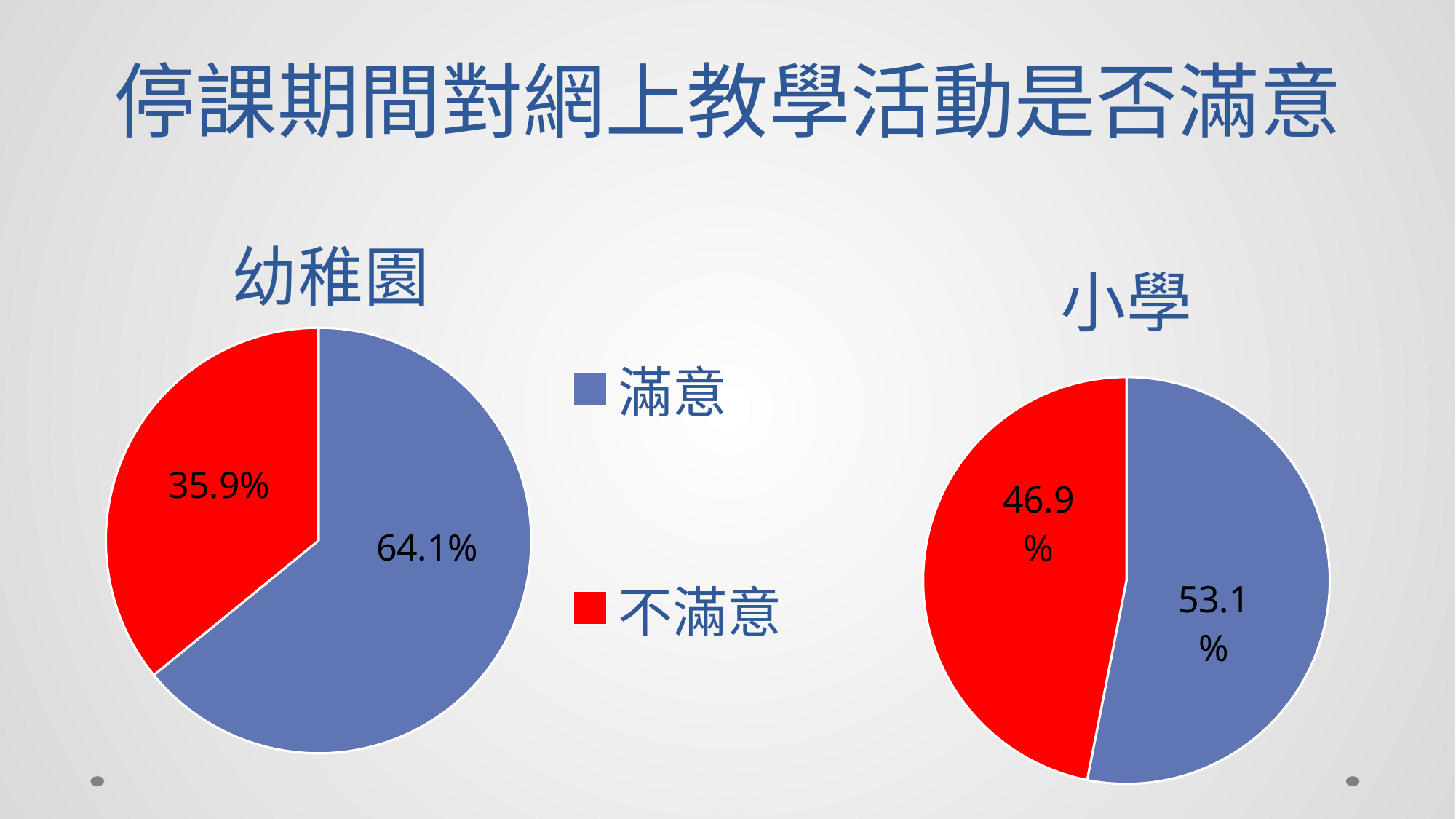
In the 小學 pie chart, what share is labelled for 滿意? 53.1% In the 幼稚園 pie chart, what share is labelled for 不滿意? 35.9% In the 幼稚園 pie chart, what share is labelled for 滿意? 64.1% What kind of chart is used for 幼稚園 and 小學? Pie chart How many slices does the 小學 pie chart have? 2 In the 幼稚園 pie chart, which slice is the largest? 滿意 In the 幼稚園 pie chart, what is the difference between the 滿意 and 不滿意 shares? 28.2% Which colour represents 不滿意 in the legend? Red In the 小學 pie chart, which slice is the smallest? 不滿意 In the 小學 pie chart, what is the difference between the 滿意 and 不滿意 shares? 6.2% In the 小學 pie chart, what share is labelled for 不滿意? 46.9% Which chart has the larger 滿意 share, 幼稚園 or 小學? 幼稚園